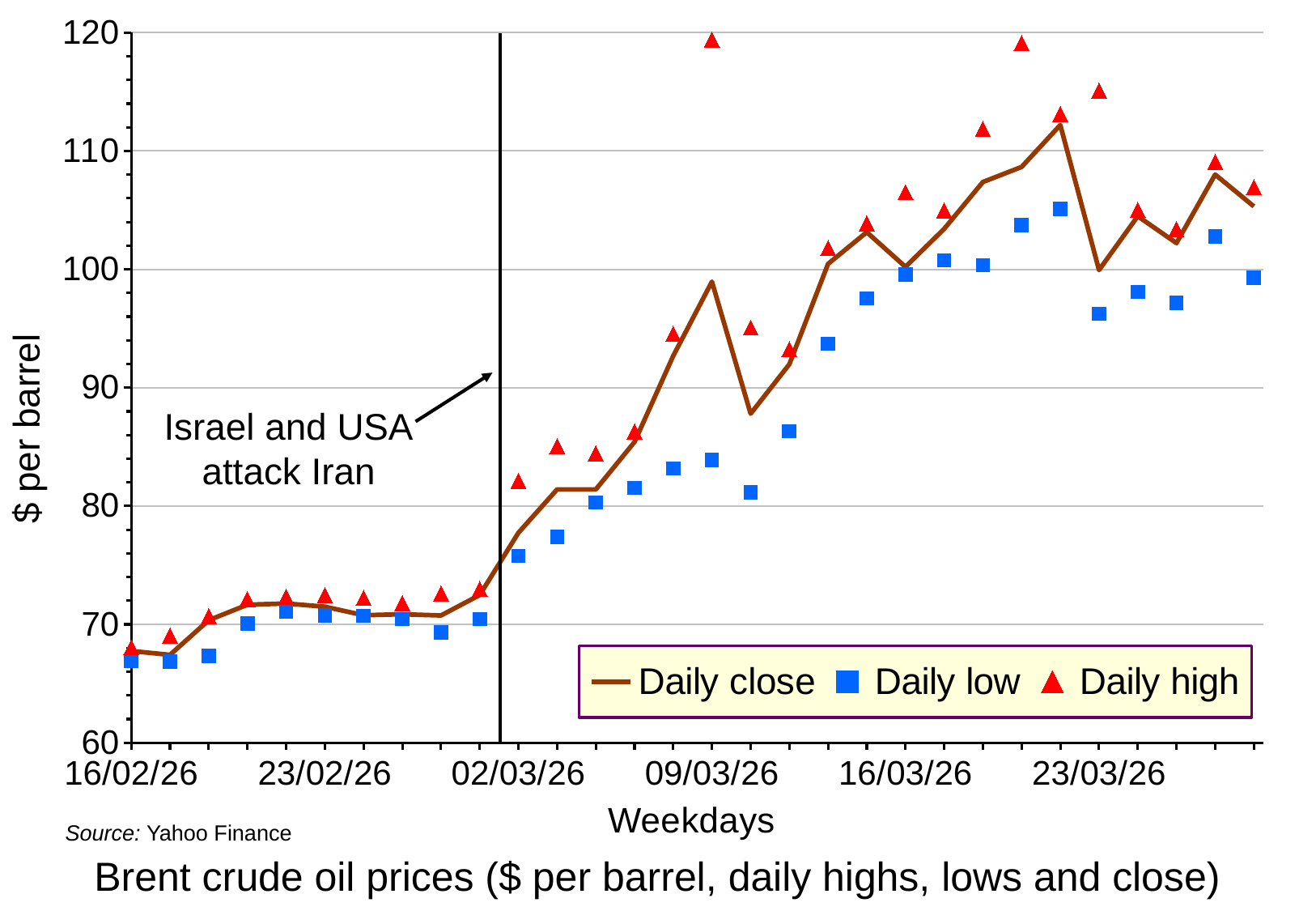
What event does the annotation with the vertical line mark? Israel and USA attack Iran Is the Daily low value on 09/03/26 greater or less than 90? less How many series does the legend list? 3 Is the Daily low value on 23/03/26 greater or less than 100? less What kind of chart is shown on the slide? line chart Is the Daily close value on 16/02/26 greater or less than 70? less What are the three series named in the legend? Daily close, Daily low, Daily high Overall, do the Daily close values rise or fall from 16/02/26 to the end of the period? rise Which is larger, the Daily close on 09/03/26 or the Daily close on 23/02/26? Daily close on 09/03/26 Which is larger, the Daily high on 09/03/26 or the Daily high on 16/03/26? Daily high on 09/03/26